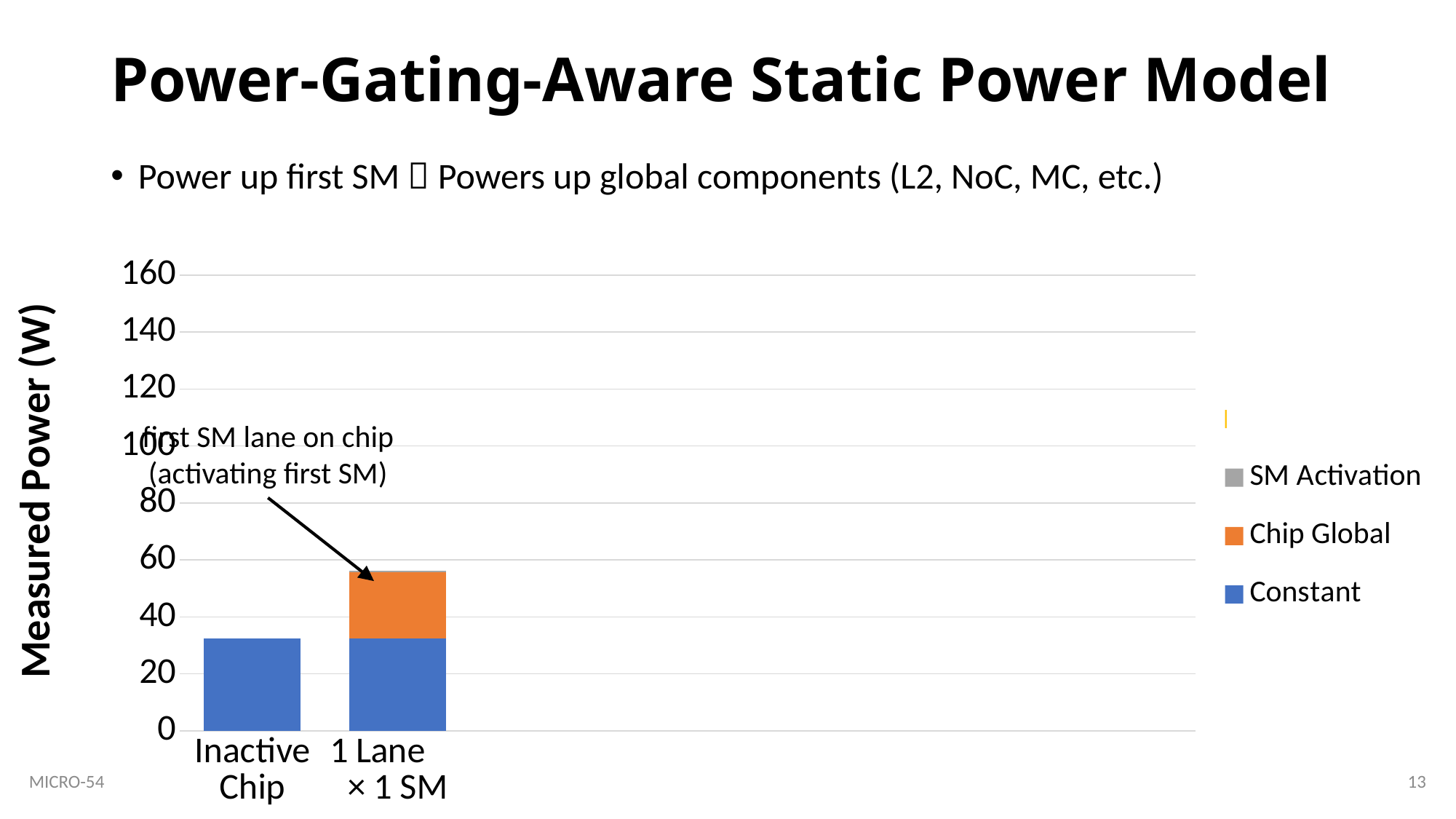
Which legend series is shown in orange? Chip Global Is the total value for Inactive Chip greater or less than 40? less Is the total value for 1 Lane × 1 SM greater or less than 40? greater Which category has the lowest total measured power? Inactive Chip Is the total value for 1 Lane × 1 SM greater or less than 80? less What is the label of the chart's y axis? Measured Power (W) How many series are named in the chart's legend? 3 Which category has the highest total measured power? 1 Lane × 1 SM Which category has the taller bar, Inactive Chip or 1 Lane × 1 SM? 1 Lane × 1 SM What kind of chart is shown on the slide? Stacked bar chart How many categories are shown on the x axis of the chart? 2